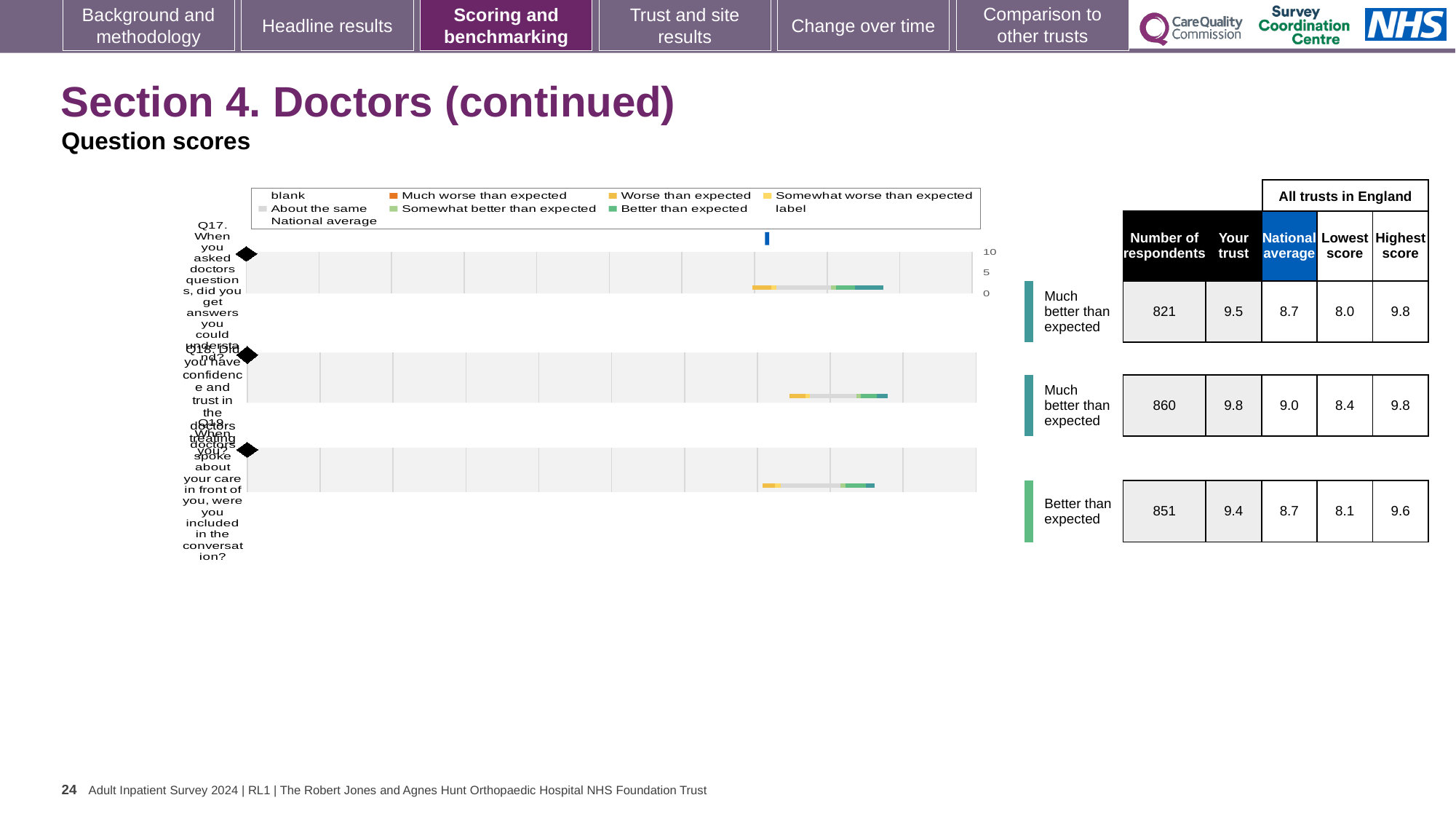
Which question has the highest 'Your trust' score in the table beside the chart? Q18 How many questions (categories) are plotted in the chart? 3 What is the maximum value shown on the chart's score axis? 10 What is the number of respondents for Q19 in the table beside the chart? 851 How many entries does the chart legend list? 9 What is the 'Your trust' score for Q17 in the table beside the chart? 9.5 What is the national average for Q18 in the table beside the chart? 9.0 Which question has the lowest number of respondents in the table beside the chart? Q17 What is the highest score across all trusts in England for Q19? 9.6 What kind of chart is shown on the slide? bar chart What is the difference between the 'Your trust' score and the national average for Q17? 0.8 Is the 'Your trust' score for Q18 higher or lower than the 'Your trust' score for Q19? higher